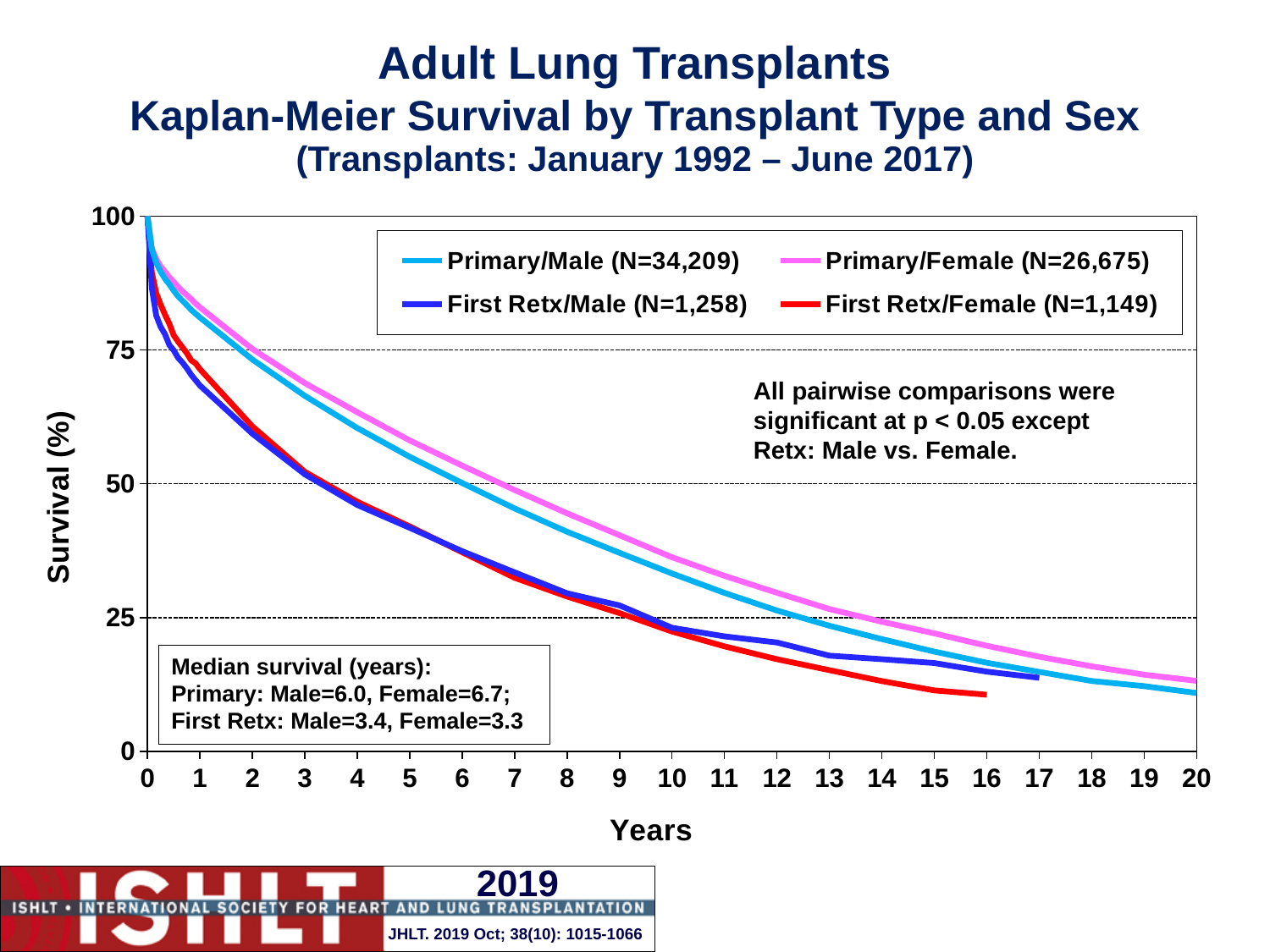
How many series does the legend list? 4 What kind of chart is shown on the slide? Line chart What is the median survival in years for Primary/Female transplants? 6.7 At 5 years, which curve shows higher survival, Primary/Male or First Retx/Male? Primary/Male Which group has the smallest N in the legend? First Retx/Female Which group has the largest N in the legend? Primary/Male What is the N for the Primary/Male group shown in the legend? 34,209 What is the difference in median survival (years) between Primary/Female and Primary/Male? 0.7 What is the median survival in years for First Retx/Male transplants? 3.4 Is the survival for First Retx/Female at 12 years greater or less than 25? less Do the survival curves rise or fall as years increase? Fall Is the survival for Primary/Female at 10 years greater or less than 25? greater